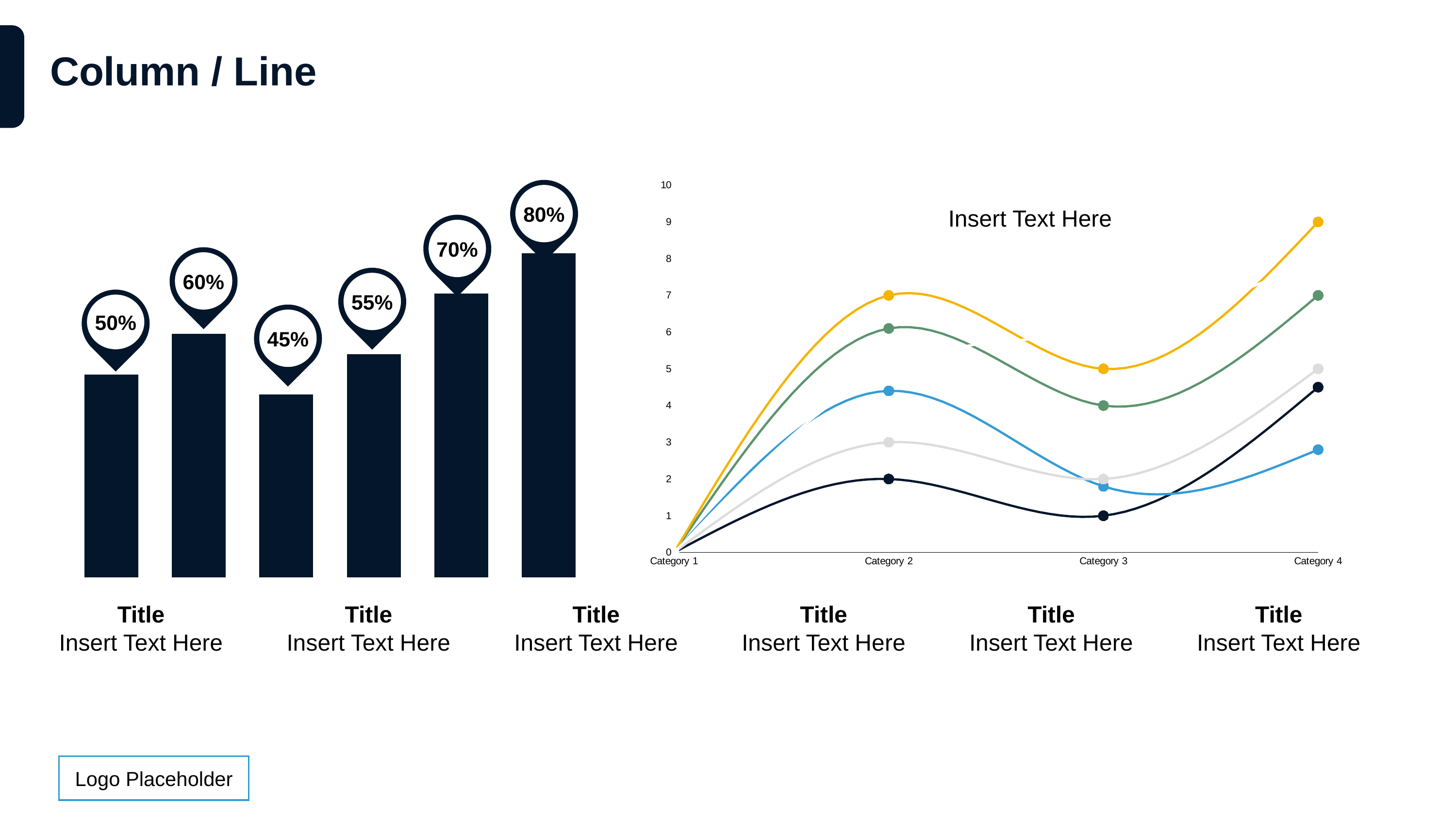
In the bar chart on the left, which is larger: the second bar from the left or the third bar from the left? the second bar (60%) In the line chart on the right, what is the value of the yellow line at Category 4? 9 In the bar chart on the left, what is the lowest value shown? 45% In the bar chart on the left, how many bars are plotted? 6 In the bar chart on the left, what is the highest value shown? 80% In the line chart on the right, is the value of the dark navy line at Category 4 greater or less than 4? greater In the bar chart on the left, what is the value of the first bar from the left? 50% What kind of chart is on the right side of the slide? line chart In the line chart on the right, how many categories are on the x axis? 4 In the line chart on the right, how many lines are plotted? 5 In the bar chart on the left, what is the difference between the highest and lowest bar values? 35% What kind of chart is on the left side of the slide? bar chart